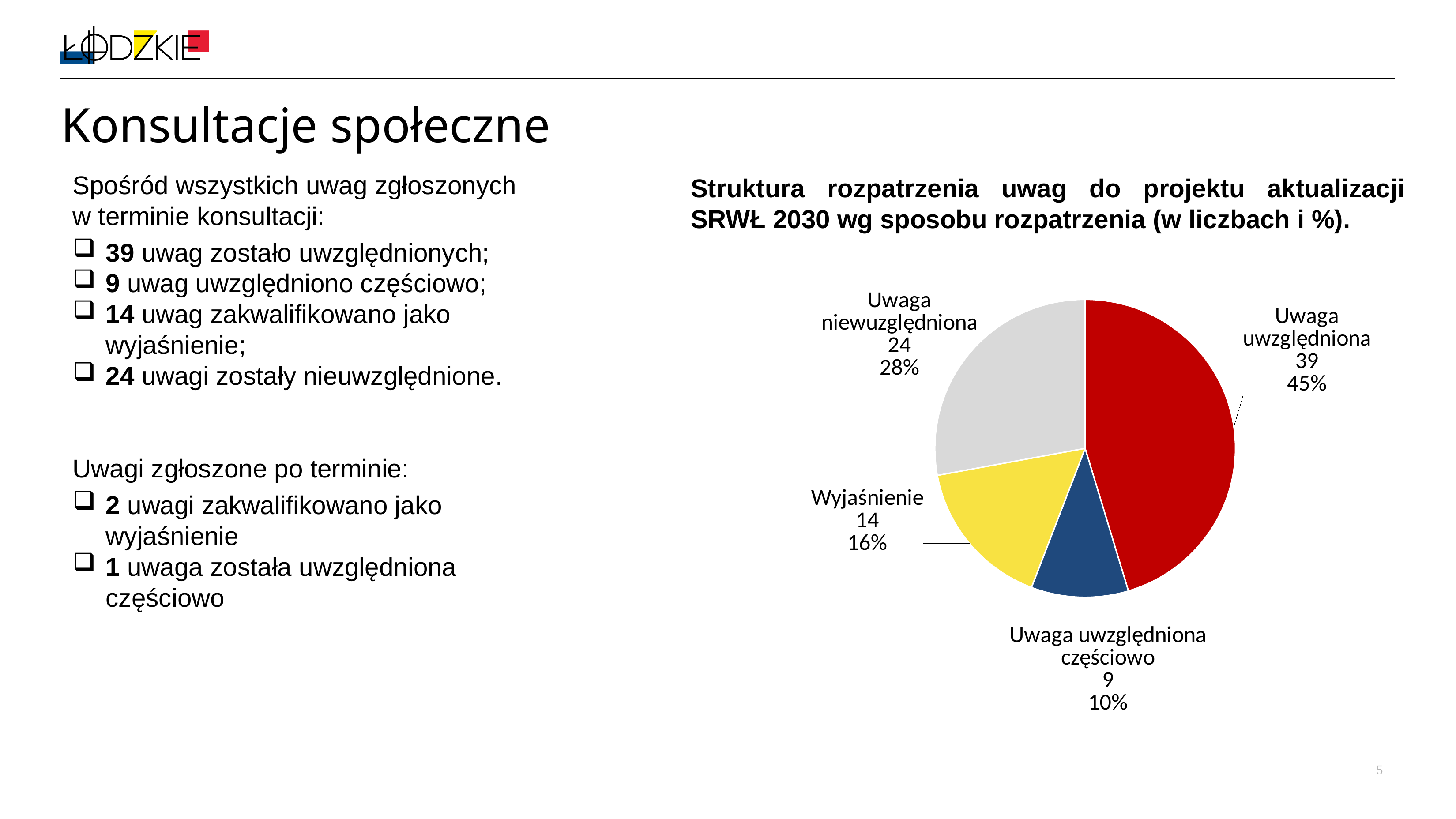
What percentage share does "Uwaga uwzględniona" have in the pie chart? 45% What is the value for "Wyjaśnienie" in the pie chart? 14 What percentage share does "Uwaga niewuzględniona" have in the pie chart? 28% What kind of chart is shown on the slide? pie chart Which category has the largest slice in the pie chart? Uwaga uwzględniona What colour is the "Wyjaśnienie" slice in the pie chart? yellow What is the difference between the values for "Uwaga uwzględniona" and "Uwaga niewuzględniona"? 15 Which category has the smallest slice in the pie chart? Uwaga uwzględniona częściowo How many slices does the pie chart have? 4 Which is larger in the pie chart: "Wyjaśnienie" or "Uwaga niewuzględniona"? Uwaga niewuzględniona What is the value for "Uwaga uwzględniona częściowo" in the pie chart? 9 What is the value for "Uwaga uwzględniona" in the pie chart? 39